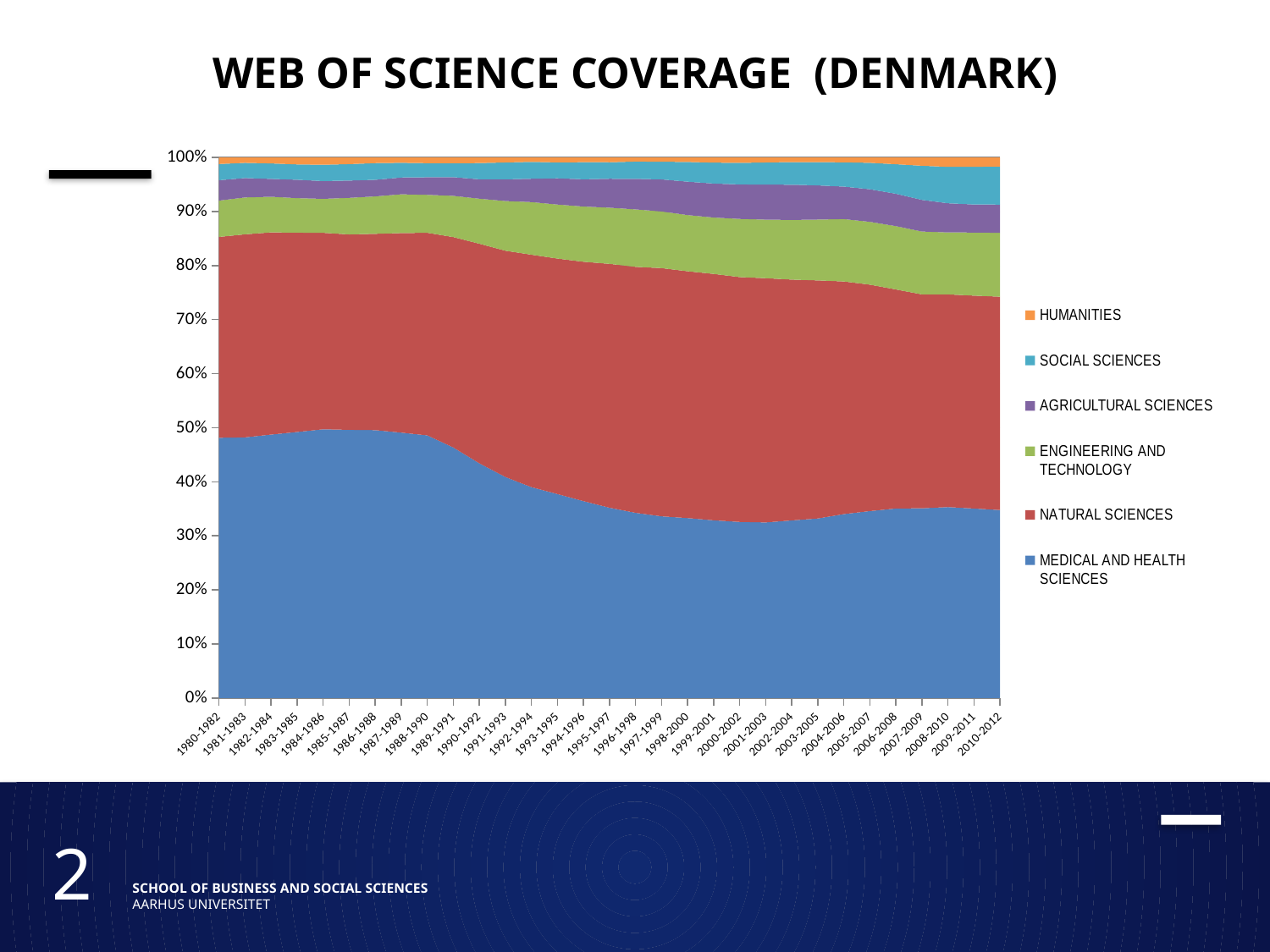
How many series does the legend list? 6 How many time periods are shown along the x axis? 31 Which series has the smallest share across the whole period? HUMANITIES Does the share of ENGINEERING AND TECHNOLOGY rise or fall overall from 1980-1982 to 2010-2012? rise What is the title of the chart? WEB OF SCIENCE COVERAGE (DENMARK) Which series is plotted at the bottom of the stacked area chart? MEDICAL AND HEALTH SCIENCES Is the cumulative top of the NATURAL SCIENCES band in 1980-1982 greater or less than 80%? greater Is the share for MEDICAL AND HEALTH SCIENCES in 2010-2012 greater or less than 40%? less In 1980-1982, which has the larger share: MEDICAL AND HEALTH SCIENCES or NATURAL SCIENCES? MEDICAL AND HEALTH SCIENCES Is the share for MEDICAL AND HEALTH SCIENCES in 1980-1982 greater or less than 40%? greater Does the share of MEDICAL AND HEALTH SCIENCES rise or fall overall from 1980-1982 to 2010-2012? fall What kind of chart is shown on the slide? Stacked area chart